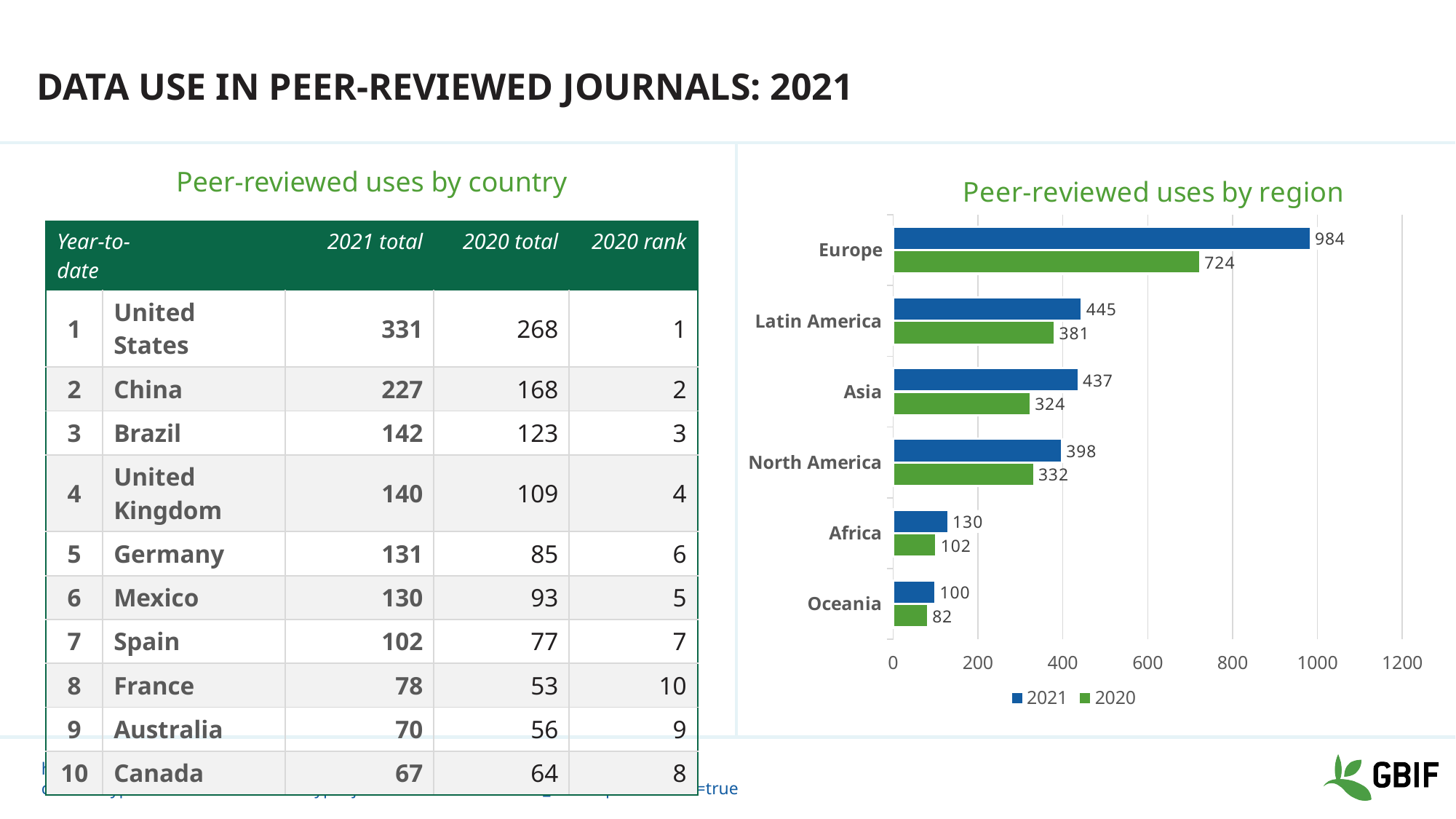
In the 'Peer-reviewed uses by region' chart, what is the difference between the 2021 values for Latin America and North America? 47 In the 'Peer-reviewed uses by region' chart, what is the 2021 value for Oceania? 100 In the 'Peer-reviewed uses by region' chart, what is the difference between the 2021 and 2020 values for Europe? 260 In the 'Peer-reviewed uses by region' chart, which is larger: the 2020 value for Latin America or the 2020 value for North America? Latin America What type of chart is 'Peer-reviewed uses by region'? bar chart In the 'Peer-reviewed uses by region' chart, which region has the lowest 2020 value? Oceania In the 'Peer-reviewed uses by region' chart, is the 2021 value for Africa greater or less than 200? less In the 'Peer-reviewed uses by region' chart, what is the 2021 value for Europe? 984 How many series does the legend of the 'Peer-reviewed uses by region' chart list? 2 How many regions are shown in the 'Peer-reviewed uses by region' chart? 6 In the 'Peer-reviewed uses by region' chart, which region has the highest 2021 value? Europe In the 'Peer-reviewed uses by region' chart, what is the 2020 value for Asia? 324